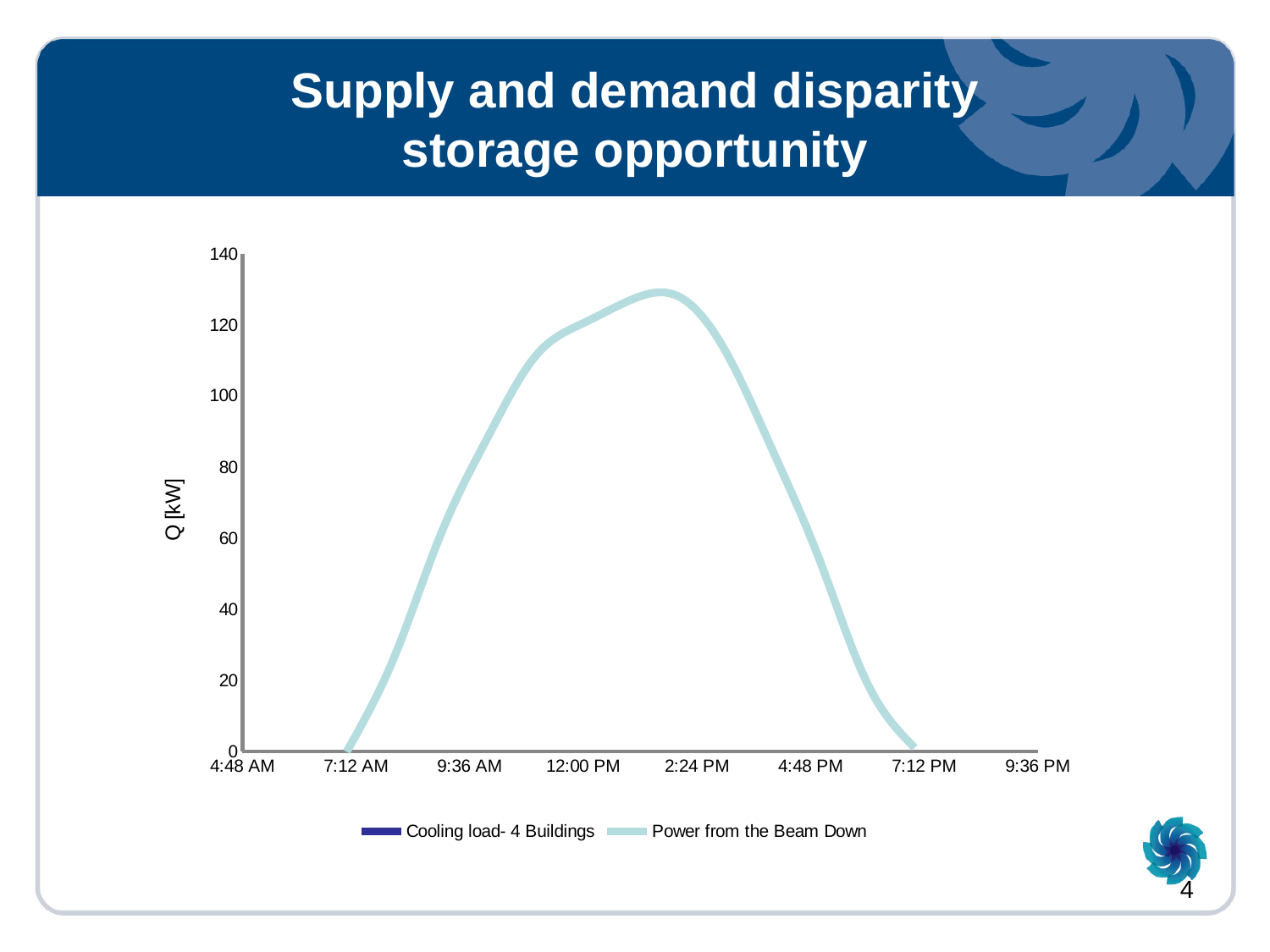
What are the two series named in the legend? Cooling load- 4 Buildings; Power from the Beam Down Between which two x-axis ticks does the Power from the Beam Down curve reach its peak? 12:00 PM and 2:24 PM What kind of chart is shown on the slide? line chart Is the peak value of the Power from the Beam Down curve greater or less than 140? less Does the Power from the Beam Down curve rise or fall between 7:12 AM and 12:00 PM? rise Is the peak value of the Power from the Beam Down curve greater or less than 120? greater How many series does the legend list? 2 Does the Power from the Beam Down curve rise or fall between 2:24 PM and 7:12 PM? fall How many time labels are shown on the x axis? 8 Is the value of Power from the Beam Down at 4:48 PM greater or less than 100? less What is the label on the y axis? Q [kW]